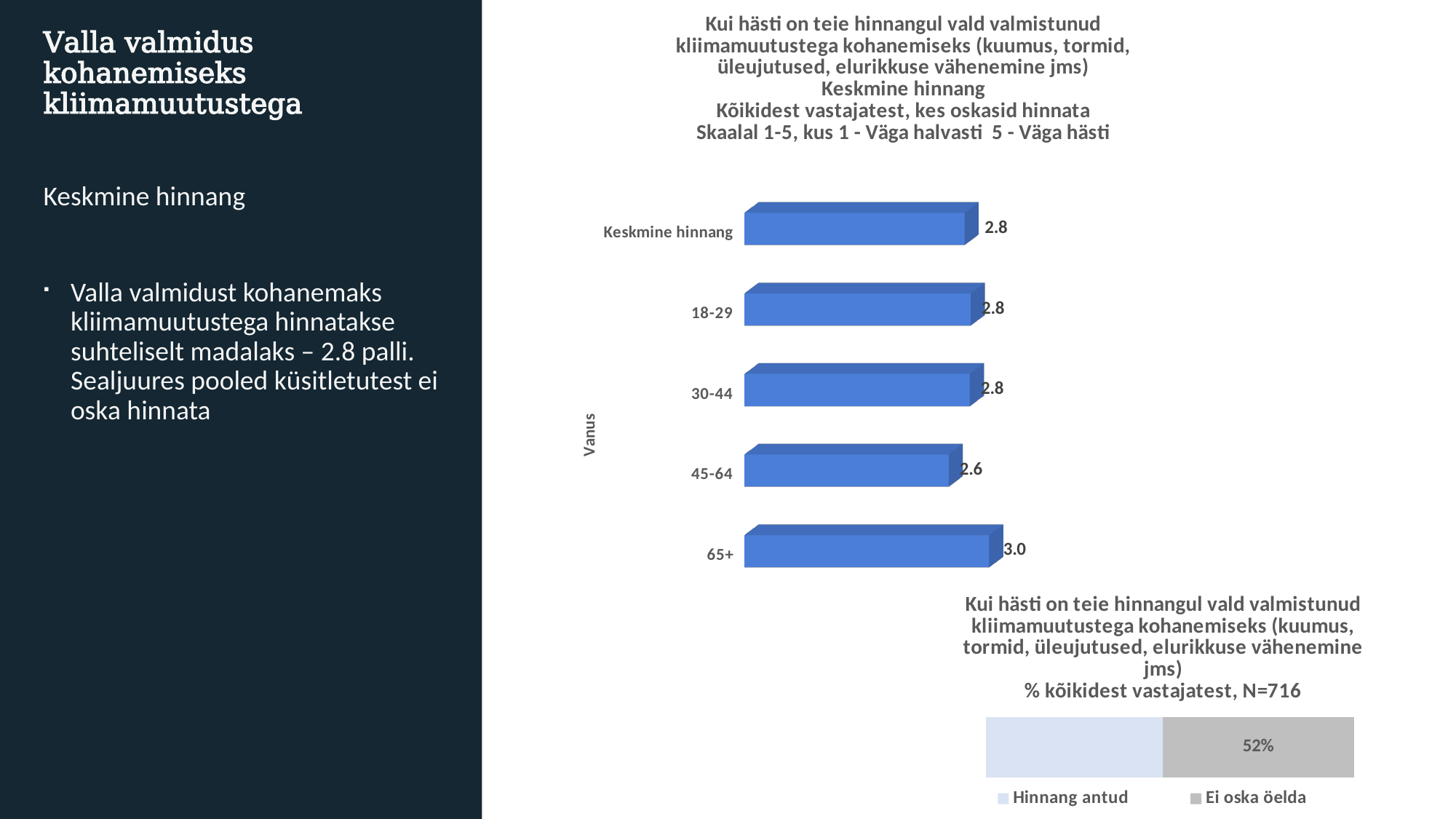
In the upper bar chart, which has a higher rating: the 18-29 group or the 45-64 group? 18-29 In the upper bar chart, what is the average rating for the 65+ age group? 3.0 In the upper bar chart, which age group has the highest average rating? 65+ In the lower stacked bar chart, what percentage of respondents answered 'Ei oska öelda'? 52% In the upper bar chart, what is the value shown for 'Keskmine hinnang'? 2.8 How many series does the legend of the lower stacked bar chart list? 2 How many bars are plotted in the upper bar chart? 5 What type of chart is the upper chart on the slide? Bar chart In the upper bar chart, which age group has the lowest average rating? 45-64 In the upper bar chart, what is the difference between the ratings of the 65+ and 45-64 age groups? 0.4 In the upper bar chart, what is the average rating for the 45-64 age group? 2.6 What is the label of the vertical axis in the upper bar chart? Vanus